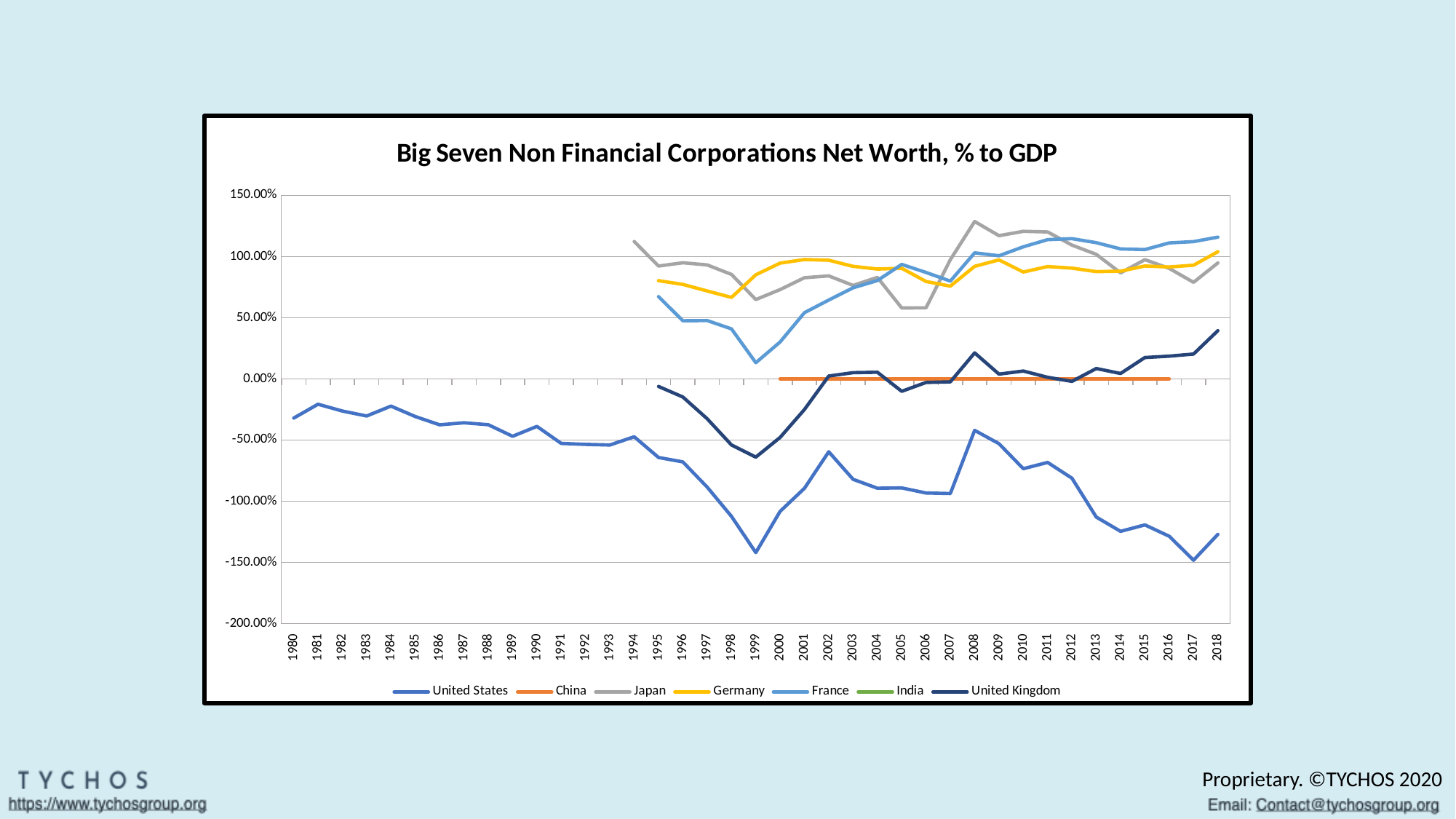
How many years are shown on the x axis? 39 Which series has the highest value in 2008? Japan In 2018, which is higher: France or United States? France Is the value for Japan in 2008 greater or less than 100.00%? greater What kind of chart is shown on the slide? line chart Is the value for United Kingdom in 1999 greater or less than -50.00%? less Which series has the lowest value in 2018? United States Is the value for France in 1999 greater or less than 50.00%? less What is the title of the chart? Big Seven Non Financial Corporations Net Worth, % to GDP How many series does the legend list? 7 Does the United Kingdom line rise or fall from 1999 to 2018? rise